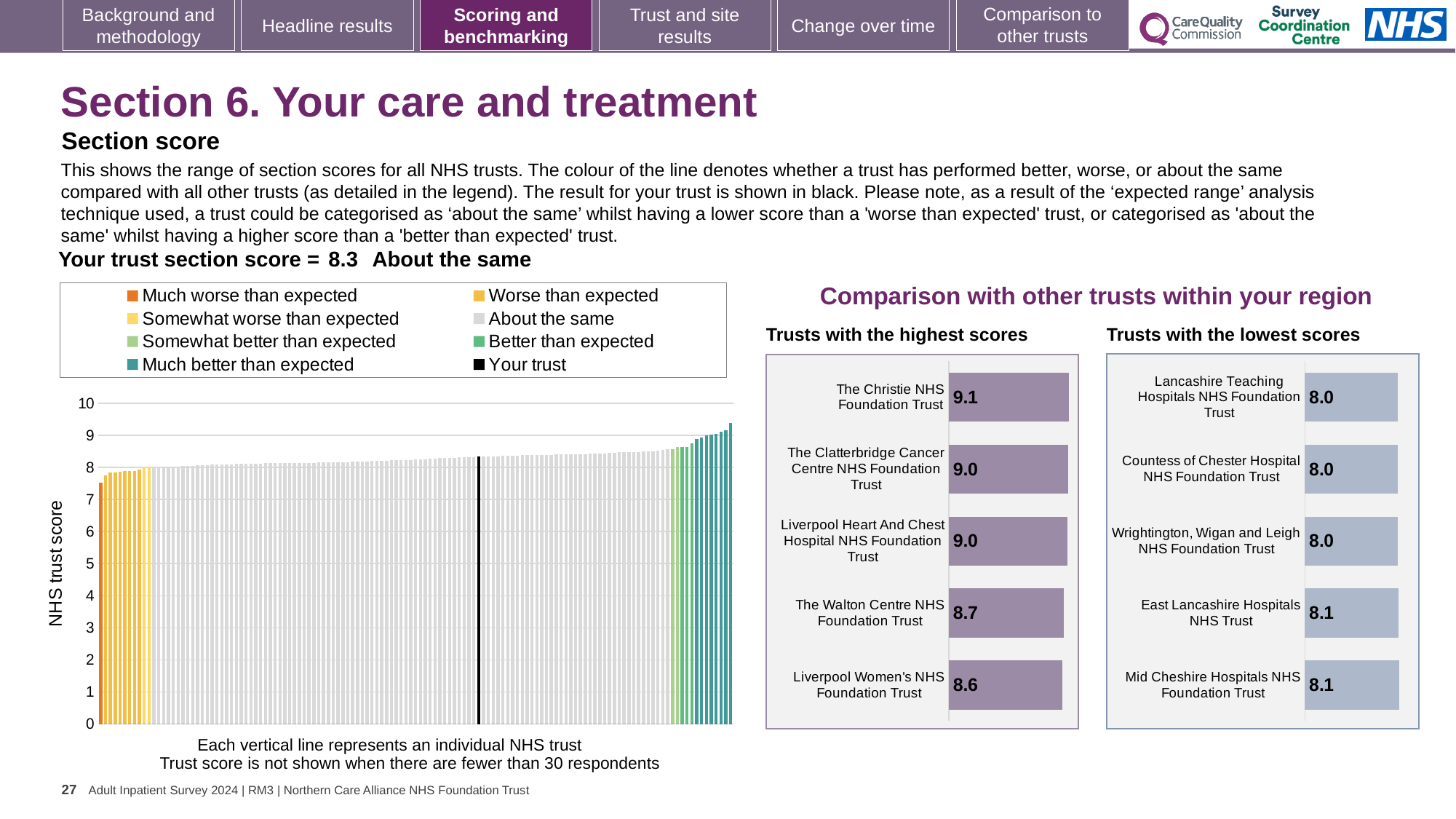
What kind of chart is the large 'NHS trust score' chart on the left? Bar chart In the 'Trusts with the highest scores' chart, which trust has the lowest score? Liverpool Women's NHS Foundation Trust In the 'Trusts with the highest scores' chart, what is the score for The Christie NHS Foundation Trust? 9.1 In the 'Trusts with the lowest scores' chart, what is the score for East Lancashire Hospitals NHS Trust? 8.1 In the 'Trusts with the highest scores' chart, how many trusts are shown? 5 In the 'Trusts with the highest scores' chart, what is the difference between the scores of The Christie NHS Foundation Trust and The Walton Centre NHS Foundation Trust? 0.4 In the 'Trusts with the lowest scores' chart, how many trusts are shown? 5 In the 'Trusts with the highest scores' chart, which trust has the highest score? The Christie NHS Foundation Trust In the large 'NHS trust score' chart on the left, how many entries does the legend list? 8 Which is larger: the score for The Walton Centre NHS Foundation Trust in the 'highest scores' chart or the score for Mid Cheshire Hospitals NHS Foundation Trust in the 'lowest scores' chart? The Walton Centre NHS Foundation Trust In the large 'NHS trust score' chart on the left, do the trust scores rise or fall from left to right along the x axis? Rise In the 'Trusts with the lowest scores' chart, what is the score for Countess of Chester Hospital NHS Foundation Trust? 8.0